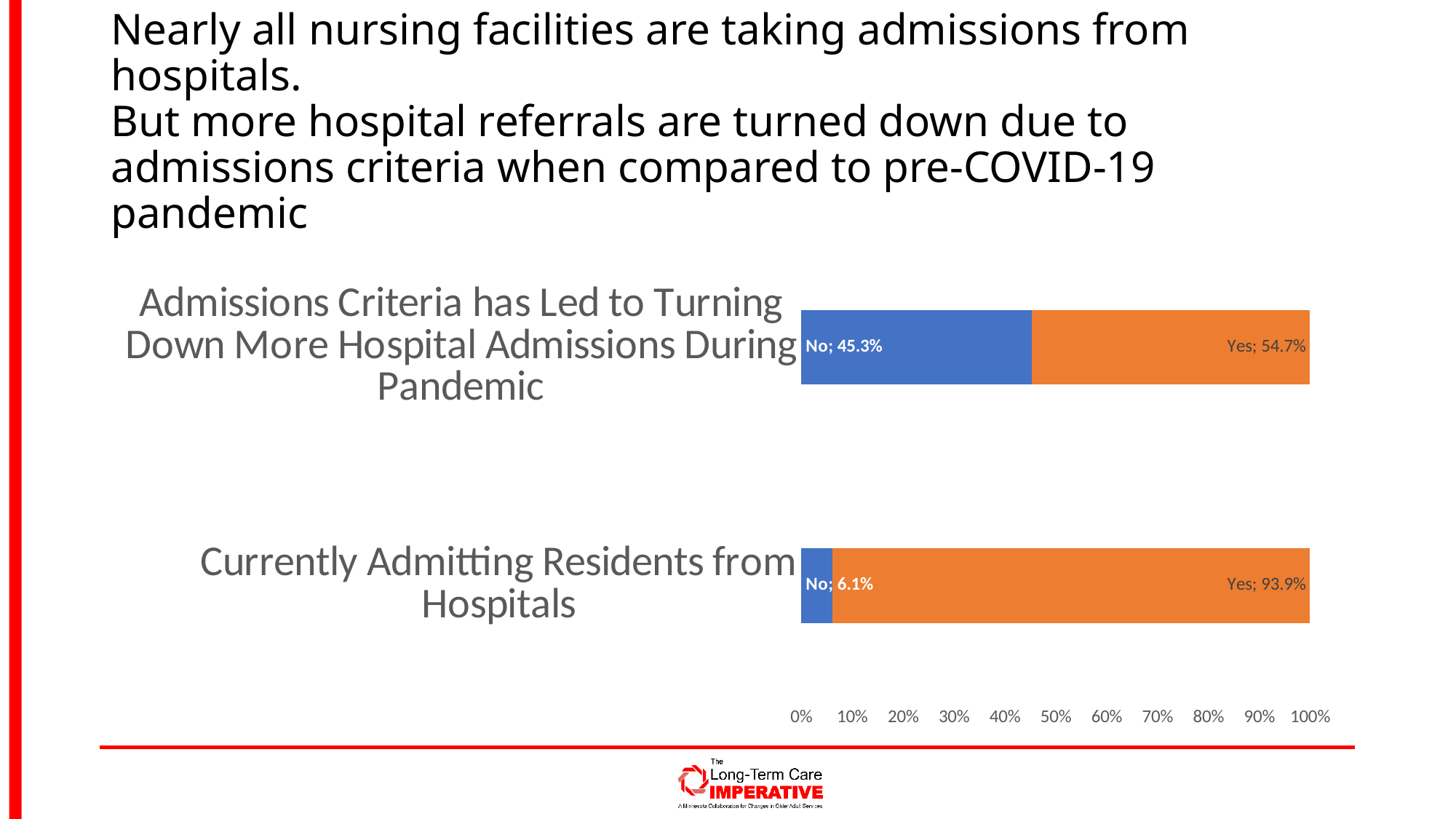
What is the difference between the "Yes" shares for Currently Admitting Residents from Hospitals and Admissions Criteria has Led to Turning Down More Hospital Admissions During Pandemic? 39.2% What percentage of facilities answered "Yes" to Currently Admitting Residents from Hospitals? 93.9% What is the difference between the "Yes" and "No" shares for Admissions Criteria has Led to Turning Down More Hospital Admissions During Pandemic? 9.4% What percentage answered "No" to Currently Admitting Residents from Hospitals? 6.1% Which category has the highest "Yes" share? Currently Admitting Residents from Hospitals What percentage answered "No" to Admissions Criteria has Led to Turning Down More Hospital Admissions During Pandemic? 45.3% How many categories are shown in the chart? 2 What percentage answered "Yes" to Admissions Criteria has Led to Turning Down More Hospital Admissions During Pandemic? 54.7% What colour represents the "Yes" responses in the chart? Orange What kind of chart is shown on the slide? Stacked bar chart Which category has the larger "No" share? Admissions Criteria has Led to Turning Down More Hospital Admissions During Pandemic What is the total of the "No" and "Yes" segments for Currently Admitting Residents from Hospitals? 100%